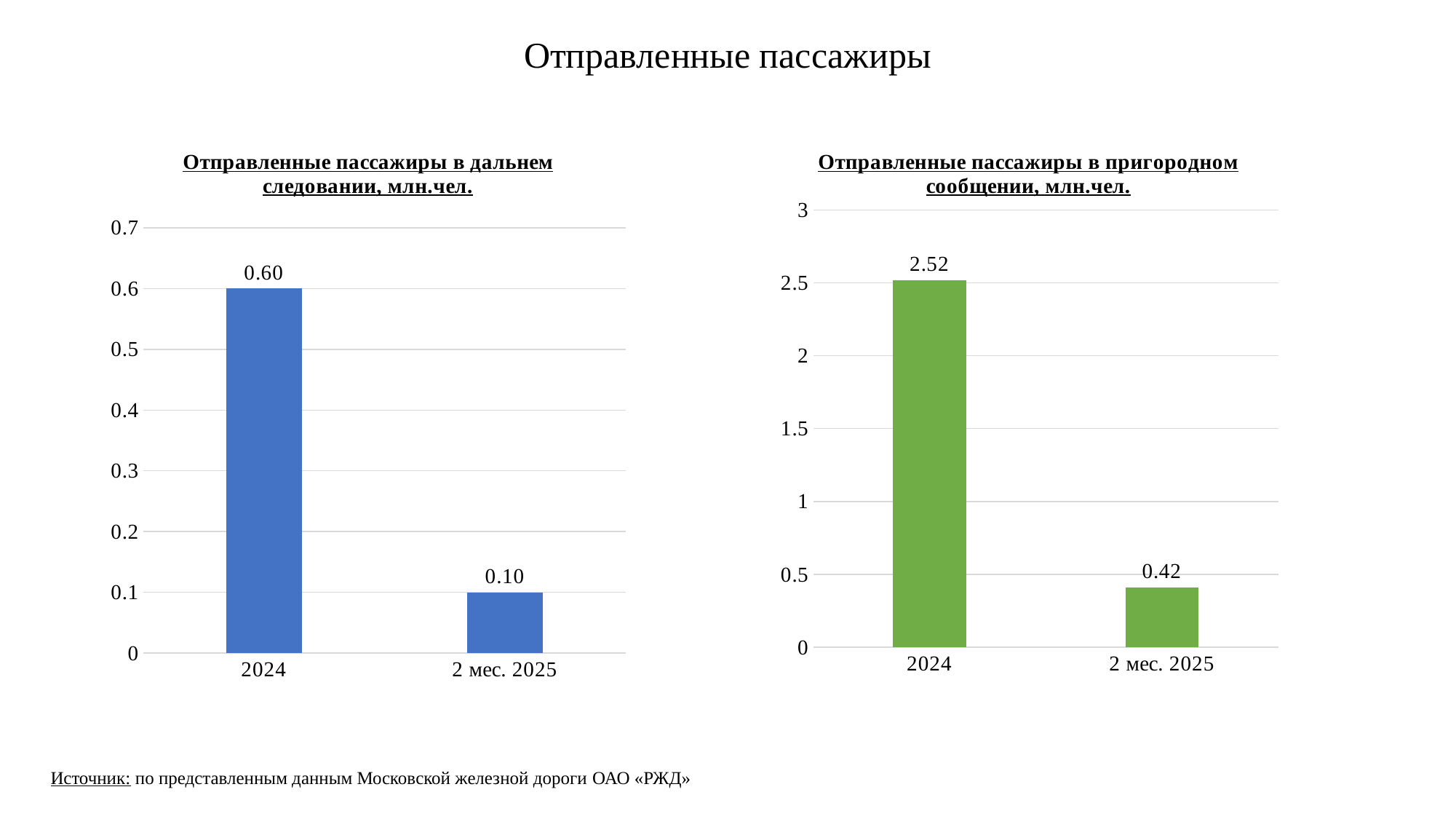
In the right chart (Отправленные пассажиры в пригородном сообщении), which category has the lowest value? 2 мес. 2025 In the left chart (Отправленные пассажиры в дальнем следовании), what is the difference between the 2024 value and the 2 мес. 2025 value? 0.50 In the left chart (Отправленные пассажиры в дальнем следовании, млн.чел.), what is the value for 2024? 0.60 In the right chart (Отправленные пассажиры в пригородном сообщении, млн.чел.), what is the value for 2 мес. 2025? 0.42 What kind of chart is the right chart (Отправленные пассажиры в пригородном сообщении)? bar chart In the left chart (Отправленные пассажиры в дальнем следовании, млн.чел.), what is the value for 2 мес. 2025? 0.10 What colour are the bars in the right chart (Отправленные пассажиры в пригородном сообщении)? green In the left chart (Отправленные пассажиры в дальнем следовании), which category has the highest value? 2024 In the right chart (Отправленные пассажиры в пригородном сообщении), what is the difference between the 2024 value and the 2 мес. 2025 value? 2.10 In the right chart (Отправленные пассажиры в пригородном сообщении), is the value for 2024 greater or less than 2? greater In the right chart (Отправленные пассажиры в пригородном сообщении, млн.чел.), what is the value for 2024? 2.52 How many categories are shown on the x axis of the left chart (Отправленные пассажиры в дальнем следовании)? 2